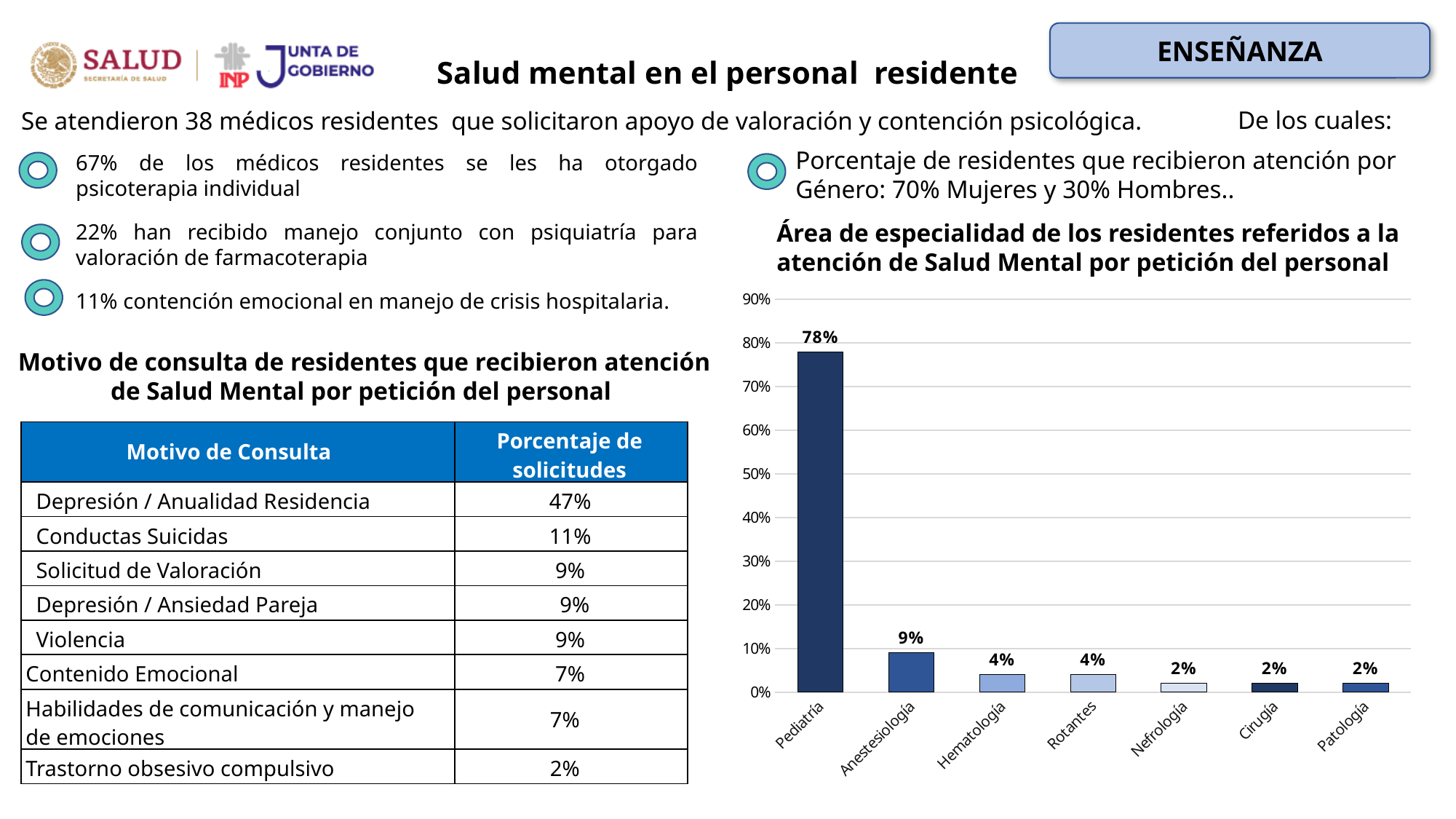
What is the title of the chart on the slide? Área de especialidad de los residentes referidos a la atención de Salud Mental por petición del personal Which specialty has the highest value in the chart? Pediatría What is the value for Hematología in the chart? 4% What is the difference between the values for Anestesiología and Rotantes? 5% Is the value for Pediatría greater or less than 70%? greater What is the value for Pediatría in the chart? 78% What kind of chart is shown on the slide? Bar chart How many specialties are shown on the x axis of the chart? 7 What is the value for Nefrología in the chart? 2% Which is larger, the value for Anestesiología or the value for Cirugía? Anestesiología What is the difference between the values for Pediatría and Anestesiología? 69% What is the value for Anestesiología in the chart? 9%